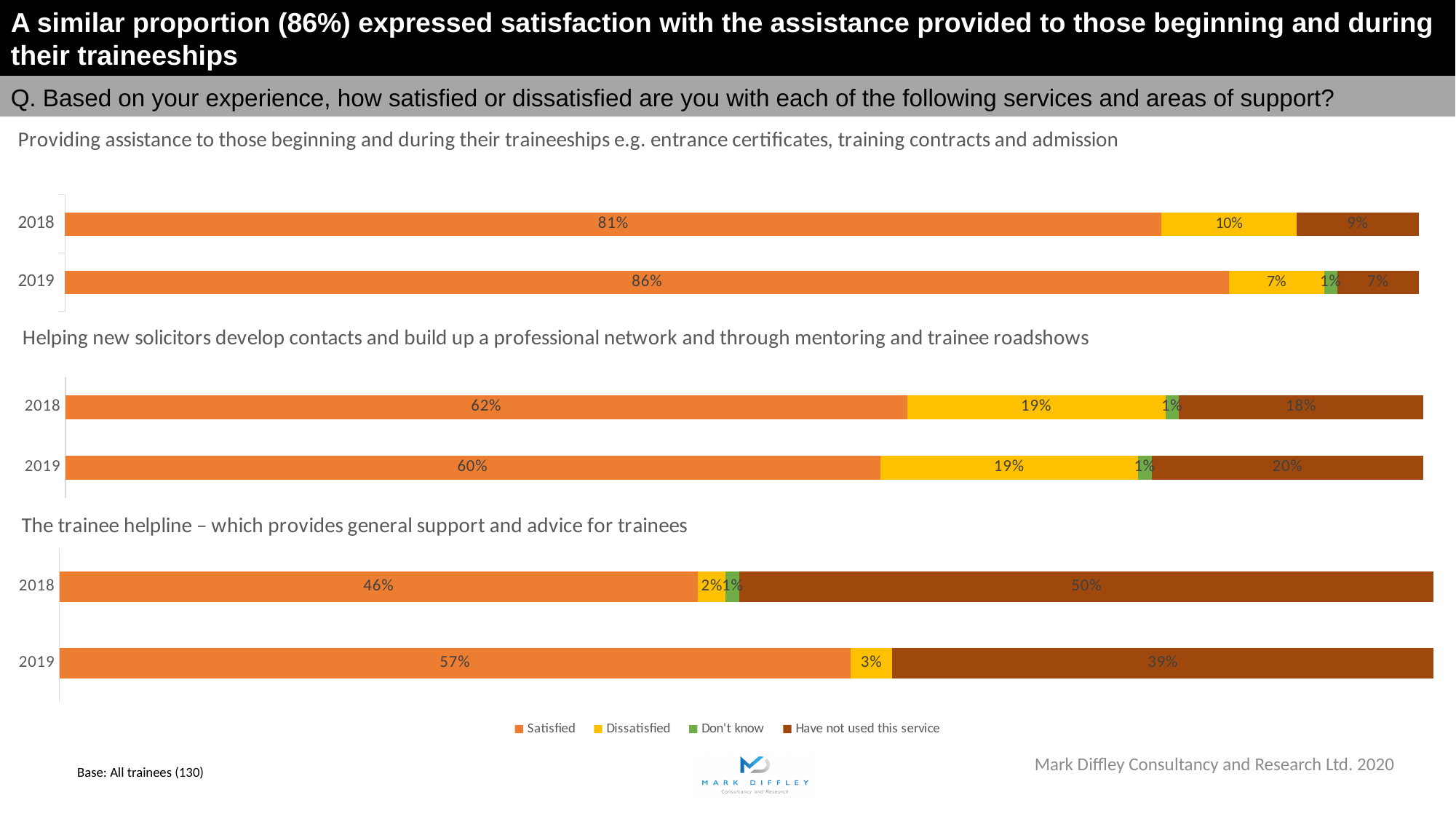
In the 'Providing assistance to those beginning and during their traineeships' chart, what percentage of trainees were satisfied in 2019? 86% In 'The trainee helpline' chart, what is the difference in the Satisfied share between 2019 and 2018? 11 percentage points In the 'Helping new solicitors develop contacts' chart, which year had the higher Satisfied share, 2018 or 2019? 2018 In the 'Providing assistance to those beginning and during their traineeships' chart, what percentage were dissatisfied in 2018? 10% In the 'Providing assistance to those beginning and during their traineeships' chart, by how many percentage points did the Satisfied share change from 2018 to 2019? 5 percentage points In 'The trainee helpline' chart, what percentage had not used this service in 2018? 50% In the 'Helping new solicitors develop contacts' chart, what percentage were dissatisfied in 2018? 19% In 'The trainee helpline' chart, what percentage were satisfied in 2019? 57% In the 'Helping new solicitors develop contacts' chart, what percentage had not used this service in 2019? 20% Which legend entry is shown in dark brown? Have not used this service How many series does the legend list for the charts on this slide? 4 What kind of chart is used for 'The trainee helpline' data? Stacked bar chart